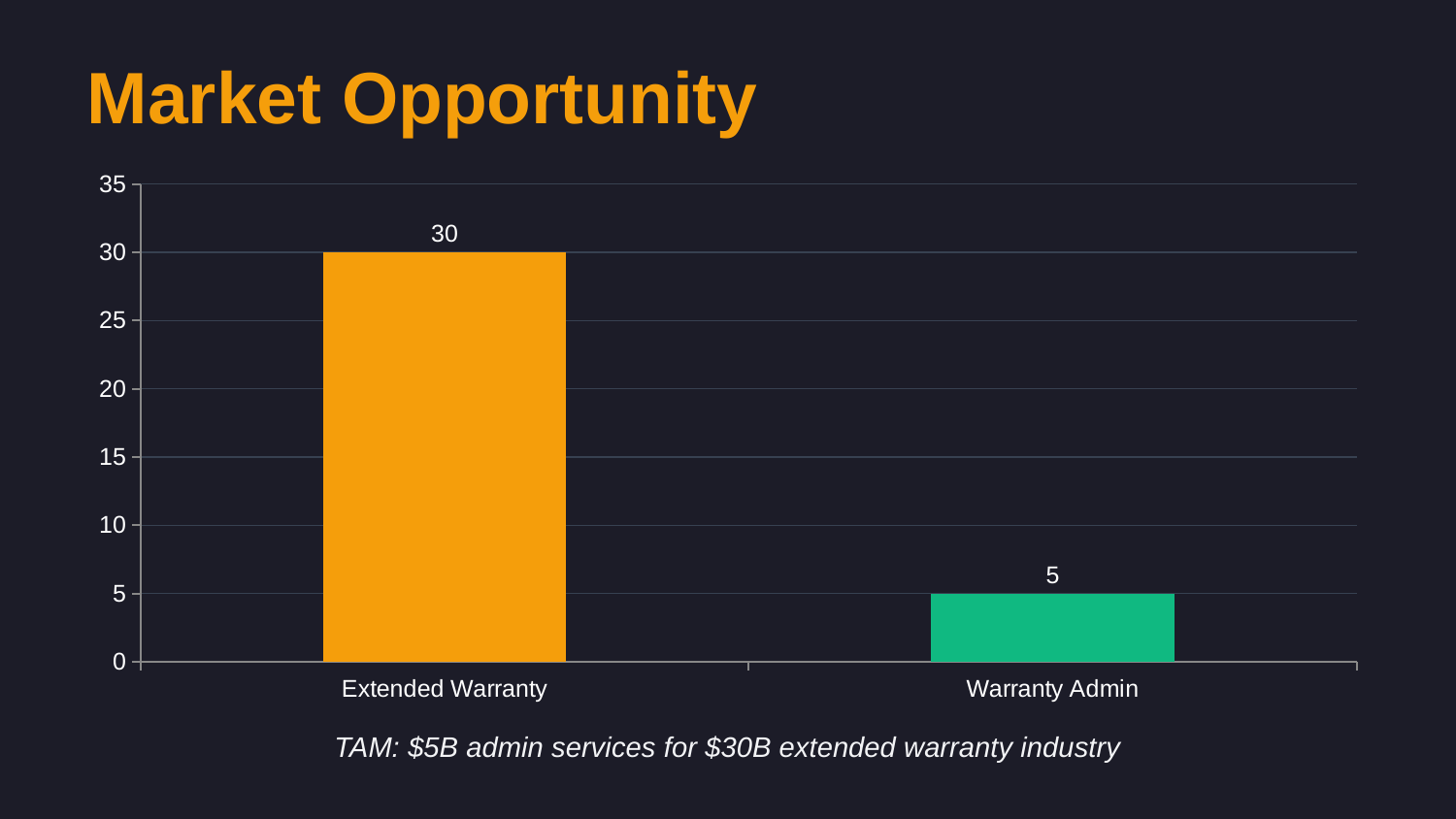
How many categories are shown on the x axis? 2 Which category has the lowest value? Warranty Admin What is the difference between the values for Extended Warranty and Warranty Admin? 25 What is the value for Extended Warranty? 30 What kind of chart is shown on the slide? bar chart Which category has the highest value? Extended Warranty What is the title of the slide? Market Opportunity Is the value for Warranty Admin greater or less than 10? less Is the value for Extended Warranty greater or less than 25? greater Which is larger, the value for Extended Warranty or the value for Warranty Admin? Extended Warranty What is the value for Warranty Admin? 5 What colour is the bar for Warranty Admin? green